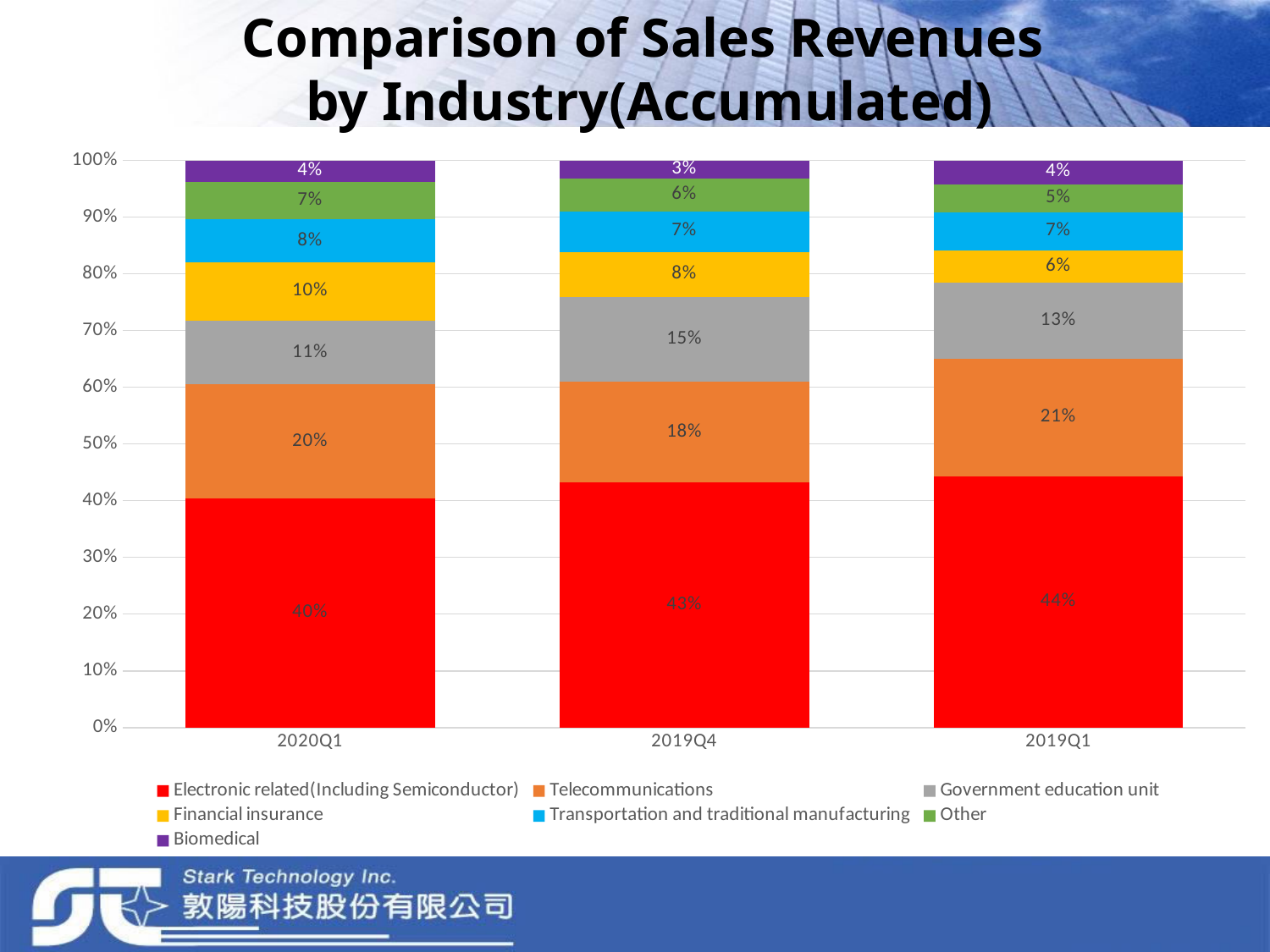
In which period is the Financial insurance share the lowest? 2019Q1 How many series does the legend list? 7 What is the value for Government education unit in 2019Q4? 15% What is the value for Telecommunications in 2019Q1? 21% What is the value for Financial insurance in 2020Q1? 10% What type of chart is shown on the slide? Stacked bar chart What is the value for Biomedical in 2019Q4? 3% What is the difference between the Telecommunications share in 2019Q1 and in 2019Q4? 3% In which period is the Electronic related(Including Semiconductor) share the highest? 2019Q1 What is the value for Electronic related(Including Semiconductor) in 2020Q1? 40% Which is larger, the Other share in 2020Q1 or in 2019Q1? 2020Q1 How many periods are shown on the x axis? 3